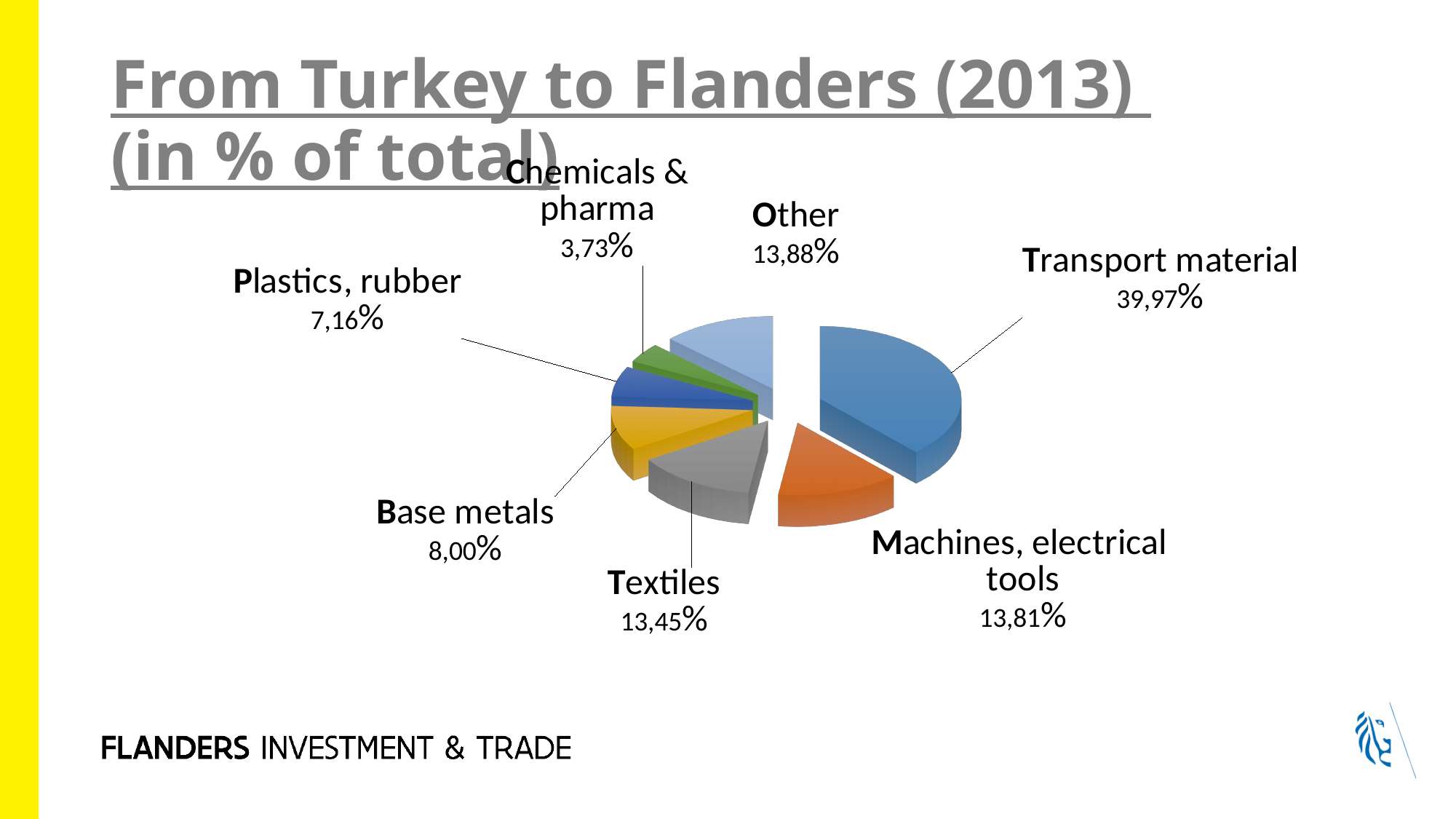
Which category has the largest share of the pie? Transport material How many categories are shown in the pie chart? 7 What share of the total does Transport material account for? 39,97% What is the value for Chemicals & pharma? 3,73% What is the difference between the shares of Base metals and Plastics, rubber? 0,84% Which is larger, the share for Textiles or the share for Base metals? Textiles What kind of chart is shown on the slide? pie chart What is the value for Textiles? 13,45% Which category has the smallest share of the pie? Chemicals & pharma What is the difference between the shares of Transport material and Machines, electrical tools? 26,16% What is the title of the chart on the slide? From Turkey to Flanders (2013) (in % of total) What is the value for Base metals? 8,00%